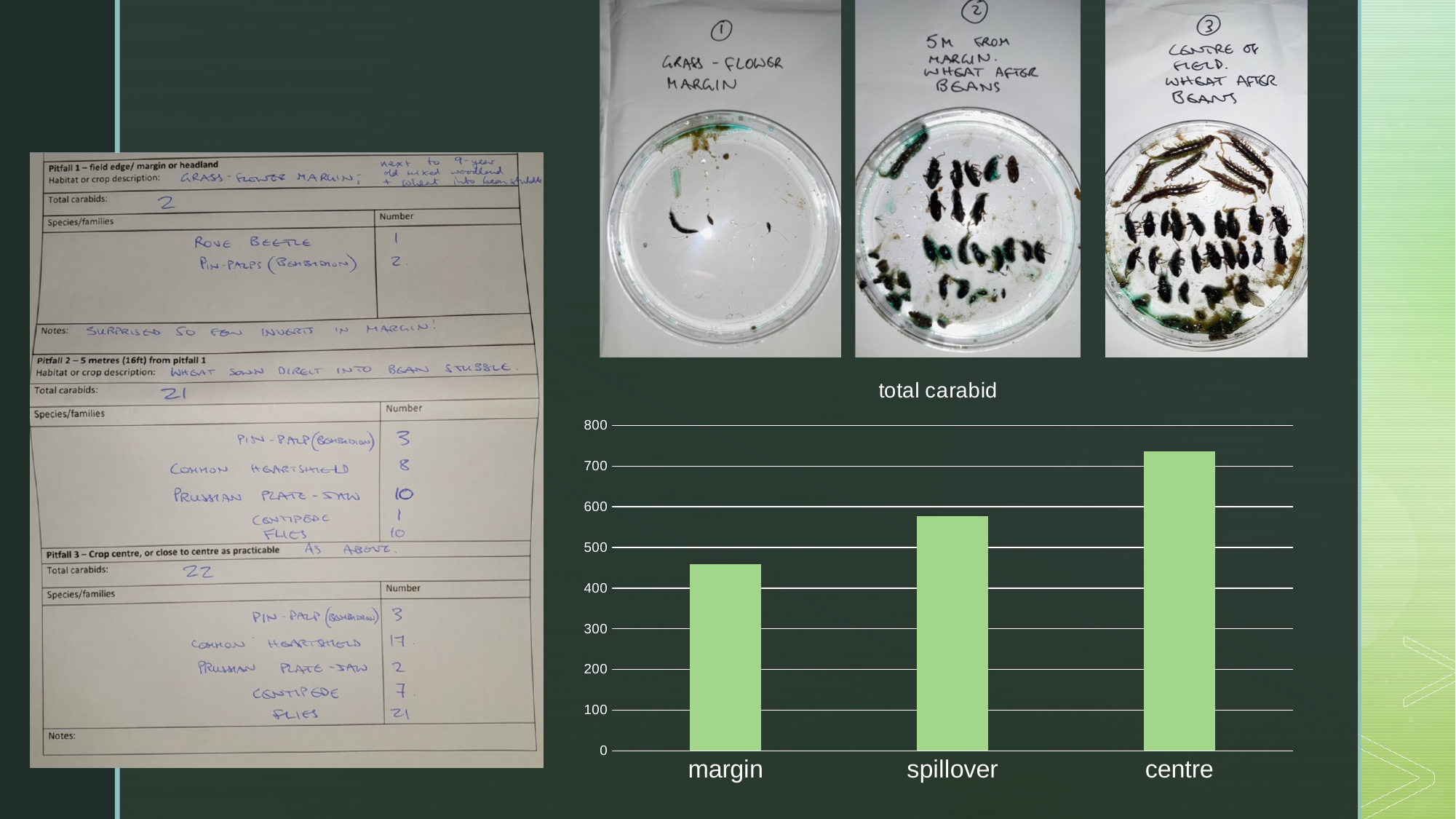
What kind of chart is shown on the slide? bar chart What is the title of the chart? total carabid Is the value for centre greater or less than 700? greater Is the value for spillover greater or less than 500? greater Is the value for margin greater or less than 500? less Which is larger, the value for centre or the value for spillover? centre Which is larger, the value for spillover or the value for margin? spillover Which category has the highest value in the chart? centre What colour are the bars in the chart? light green Do the values rise or fall from margin to centre along the x axis? rise How many categories are plotted in the chart? 3 Which category has the lowest value in the chart? margin